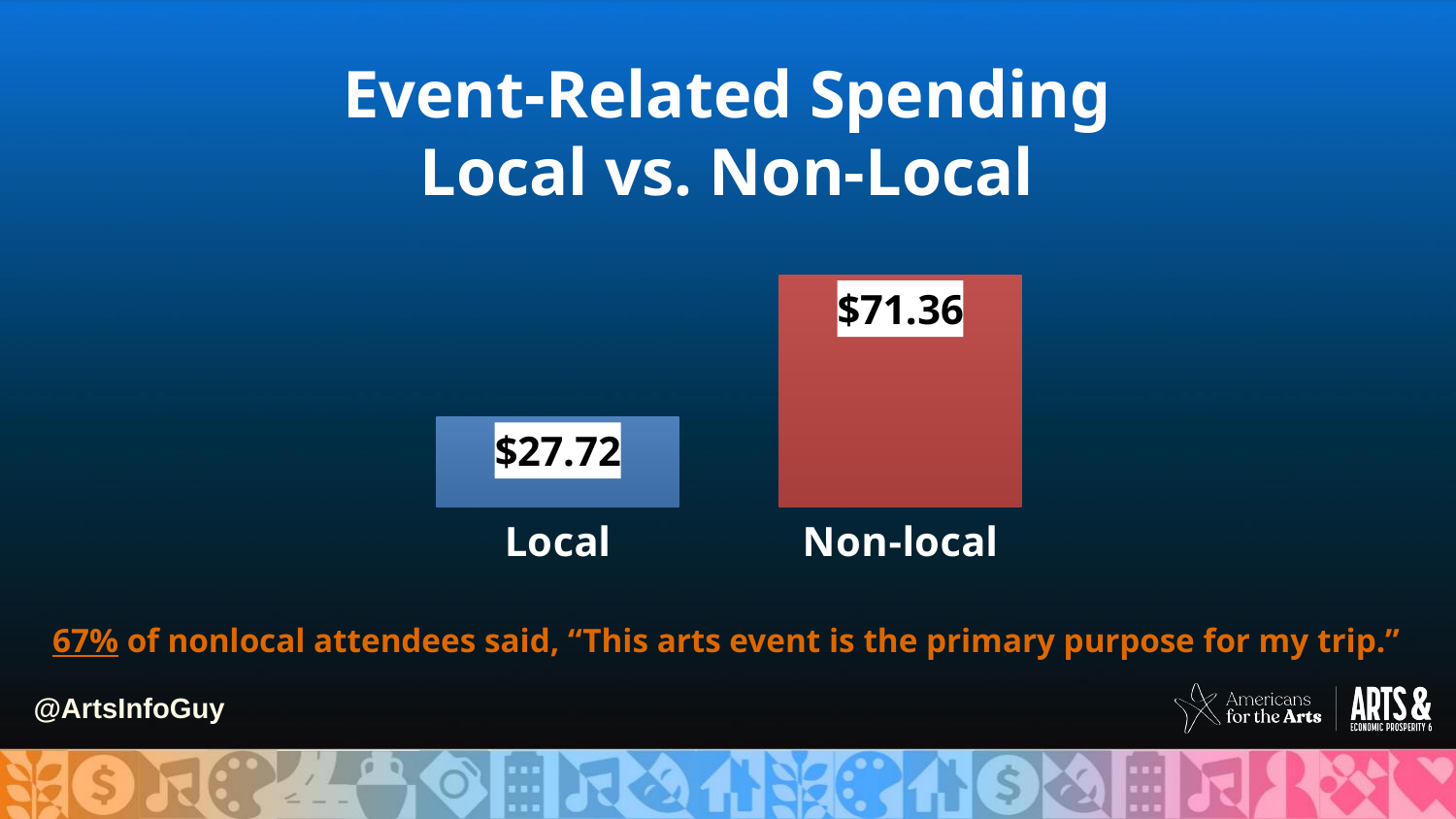
How many categories are shown in the chart? 2 What is the title of the chart on the slide? Event-Related Spending Local vs. Non-Local Which category has the lower event-related spending? Local What is the event-related spending value for Local attendees? $27.72 Which category has the higher event-related spending? Non-local What is the difference in spending between Non-local and Local attendees? $43.64 What colour is the bar for Non-local attendees? red What kind of chart is shown on the slide? bar chart What is the event-related spending value for Non-local attendees? $71.36 Is the spending for Local attendees larger or smaller than for Non-local attendees? smaller